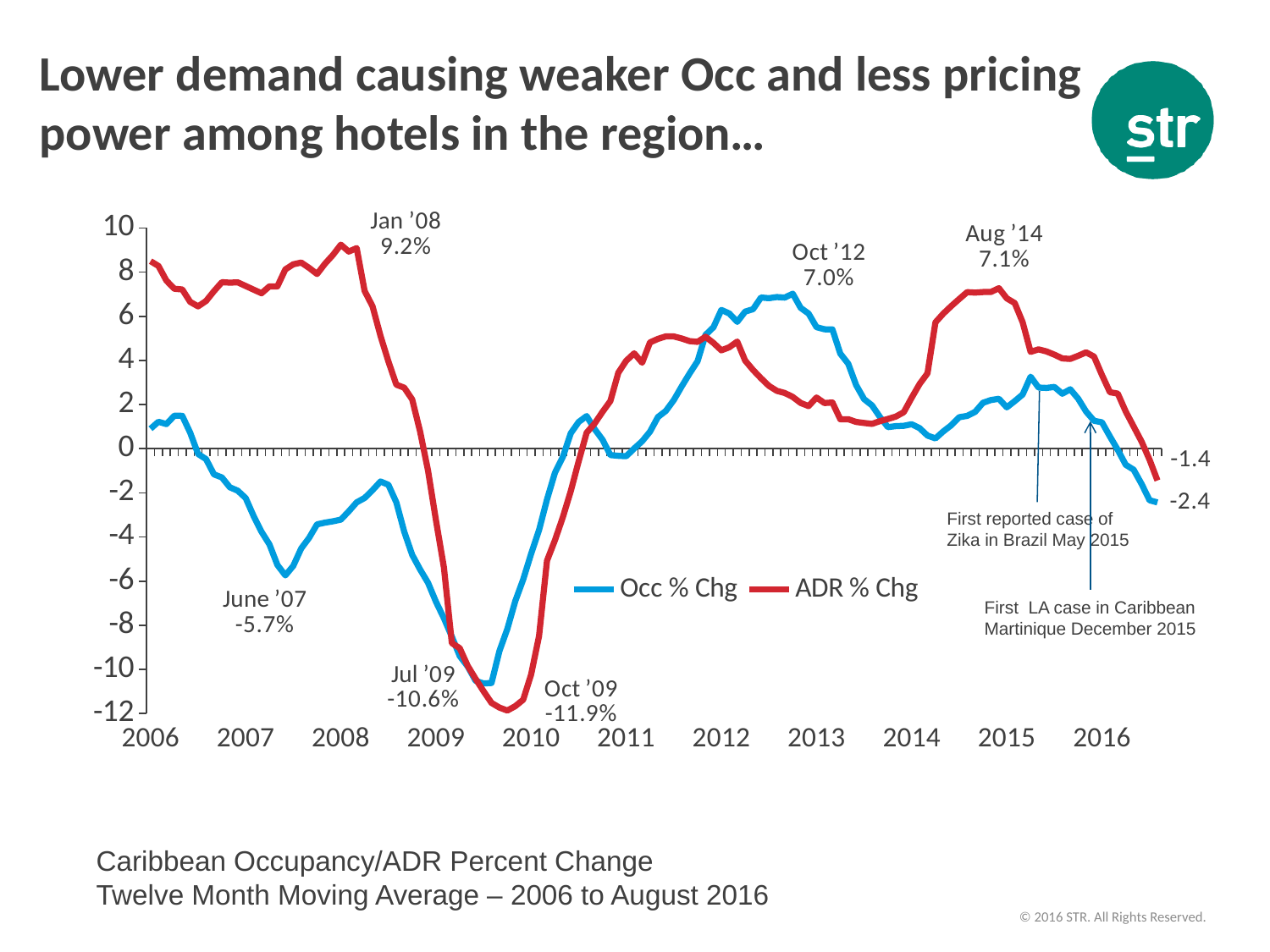
What value is labeled for Occ % Chg at June '07? -5.7% What value is labeled for Occ % Chg at Oct '12? 7.0% What is the final labeled value of the Occ % Chg line at the right end of the chart? -2.4 How many series does the legend list? 2 What is the final labeled value of the ADR % Chg line at the right end of the chart? -1.4 What is the difference between the ADR % Chg peak at Jan '08 (9.2%) and the ADR % Chg low at Oct '09 (-11.9%)? 21.1 percentage points What value is labeled for ADR % Chg at Oct '09? -11.9% What value is labeled for ADR % Chg at Aug '14? 7.1% Which is lower, the Occ % Chg value at Jul '09 or the ADR % Chg value at Oct '09? ADR % Chg at Oct '09 What value is labeled for ADR % Chg at Jan '08? 9.2% What kind of chart is shown on the slide? Line chart What are the two series named in the legend? Occ % Chg and ADR % Chg